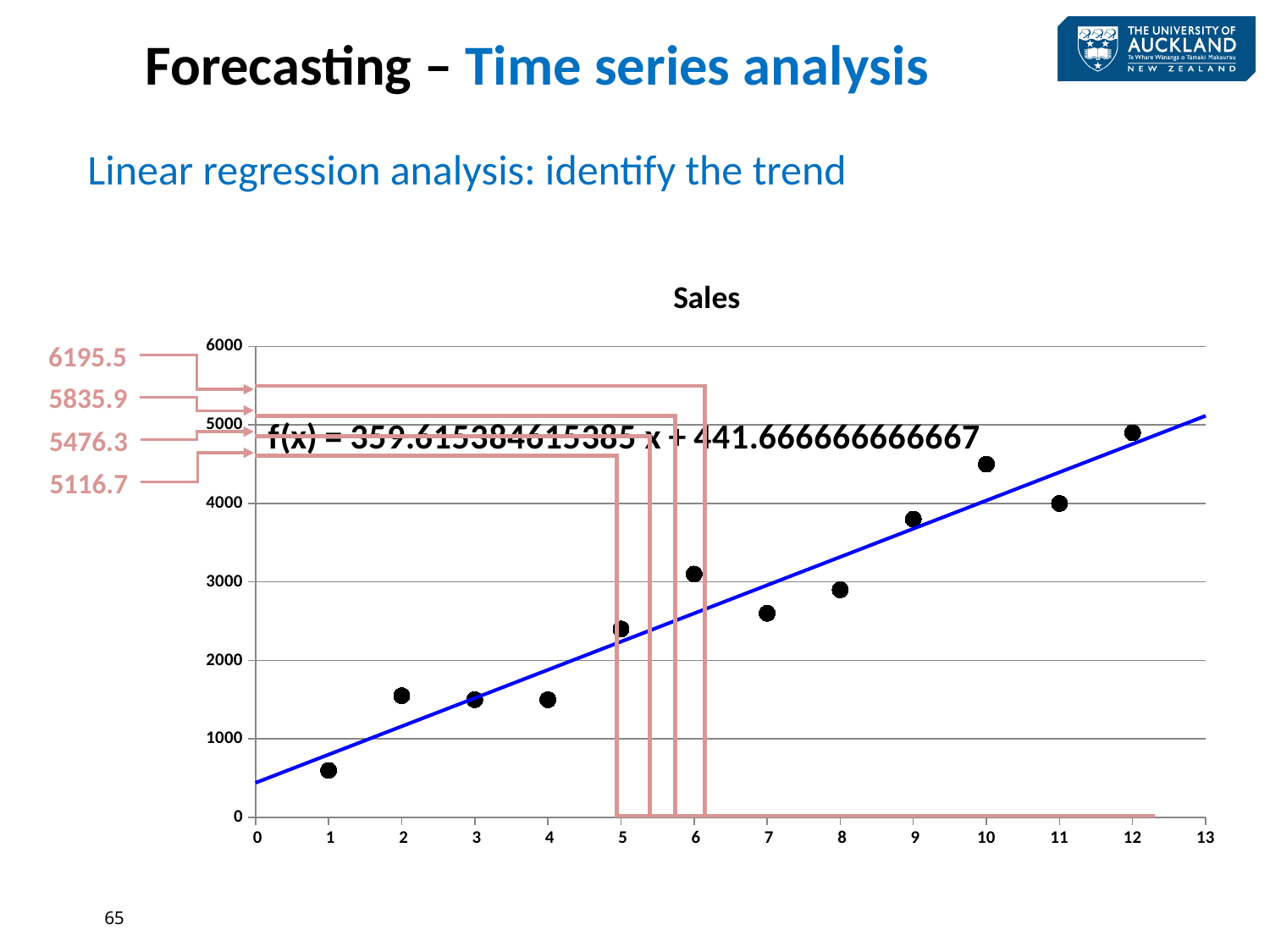
Is the plotted value at x = 1 greater or less than 1000? less At which x value is the plotted sales point highest? 12 Is the plotted value at x = 10 greater or less than 4000? greater What is the title of the chart? Sales What kind of chart is shown on the slide? scatter chart Do the plotted sales values generally rise or fall as x increases from 1 to 12? rise Is the plotted value at x = 7 greater or less than 3000? less Which plotted point is higher, the one at x = 10 or the one at x = 11? x = 10 What is the trendline equation displayed on the chart? f(x) = 359.615384615385 x + 441.666666666667 How many data points are plotted on the chart? 12 At which x value is the plotted sales point lowest? 1